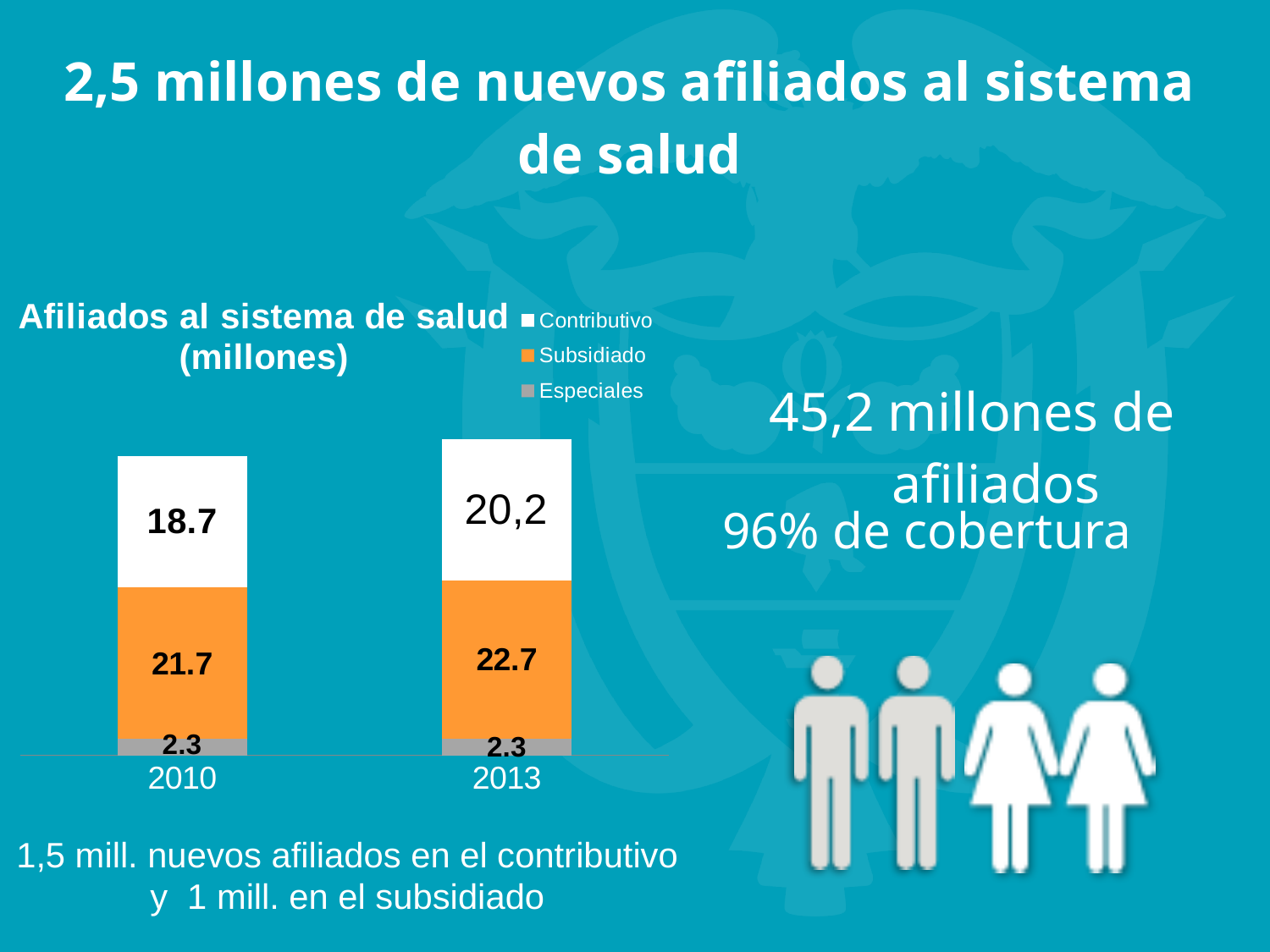
How many series does the legend list? 3 What is the value for Contributivo in 2010? 18.7 What is the value for Especiales in 2010? 2.3 What is the total of the stacked bar for 2013? 45.2 What is the total of the stacked bar for 2010? 42.7 What type of chart is shown on the slide? Stacked bar chart Is the Subsidiado value larger in 2010 or in 2013? 2013 What is the difference between the Subsidiado values for 2013 and 2010? 1.0 What is the value for Contributivo in 2013? 20,2 What is the value for Subsidiado in 2013? 22.7 Which series has the lowest value in 2013? Especiales Which series has the highest value in 2010? Subsidiado